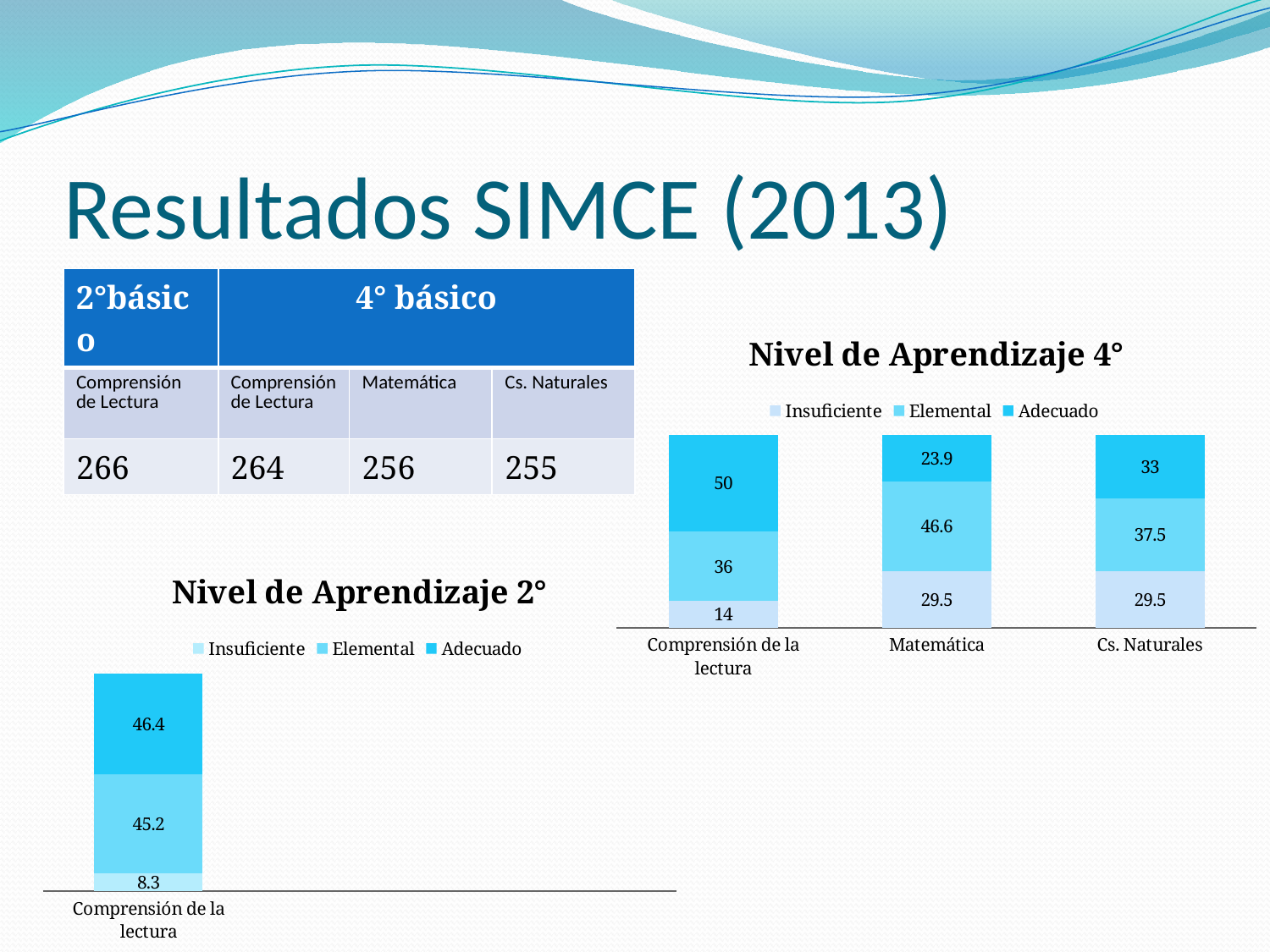
How many categories are shown on the x axis of the 'Nivel de Aprendizaje 4°' chart? 3 In the 'Nivel de Aprendizaje 4°' chart, which is larger: the Elemental value for Matemática or the Elemental value for Cs. Naturales? Matemática In the 'Nivel de Aprendizaje 4°' chart, what is the Adecuado value for Comprensión de la lectura? 50 In the 'Nivel de Aprendizaje 4°' chart, what is the difference between the Adecuado values for Cs. Naturales and Matemática? 9.1 In the 'Nivel de Aprendizaje 2°' chart, what is the Insuficiente value? 8.3 In the 'Nivel de Aprendizaje 4°' chart, what is the Elemental value for Matemática? 46.6 In the 'Nivel de Aprendizaje 4°' chart, which category has the lowest Insuficiente value? Comprensión de la lectura What kind of chart is 'Nivel de Aprendizaje 4°'? Stacked bar chart In the 'Nivel de Aprendizaje 4°' chart, which category has the highest Adecuado value? Comprensión de la lectura In the 'Nivel de Aprendizaje 2°' chart, what is the Elemental value for Comprensión de la lectura? 45.2 How many series does the legend of the 'Nivel de Aprendizaje 2°' chart list? 3 In the 'Nivel de Aprendizaje 4°' chart, what is the Insuficiente value for Cs. Naturales? 29.5